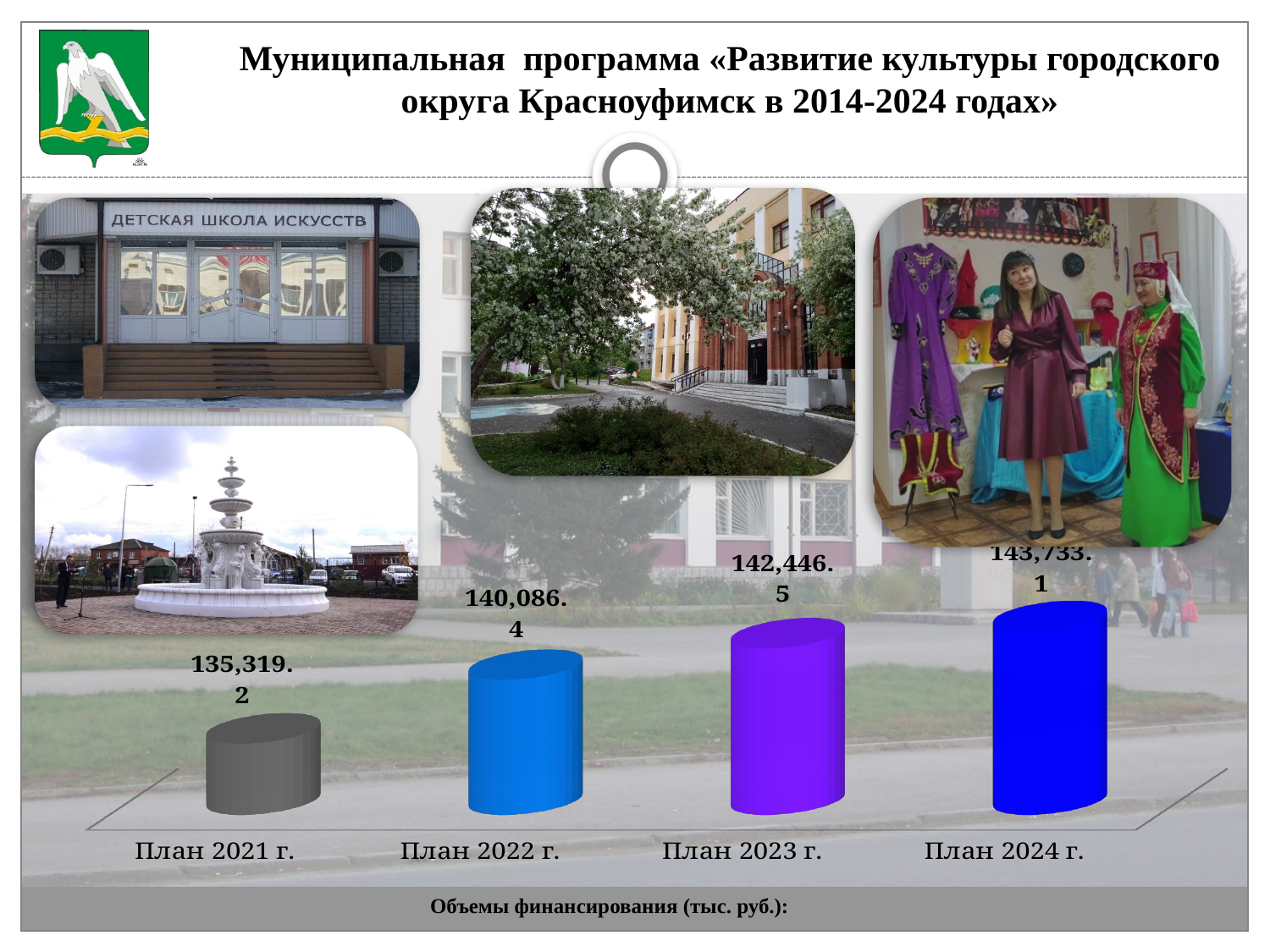
How many categories are shown in the chart? 4 What kind of chart is shown on the slide? bar chart What is the difference between the values for План 2024 г. and План 2023 г.? 1,286.6 What is the difference between the values for План 2022 г. and План 2021 г.? 4,767.2 Which is larger, the value for План 2023 г. or the value for План 2022 г.? План 2023 г. Which category has the lowest value? План 2021 г. What is the value for План 2022 г.? 140,086.4 What is the value for План 2021 г.? 135,319.2 Which category has the highest value? План 2024 г. Do the values rise or fall from План 2021 г. to План 2024 г.? rise What is the value for План 2024 г.? 143,733.1 What is the value for План 2023 г.? 142,446.5